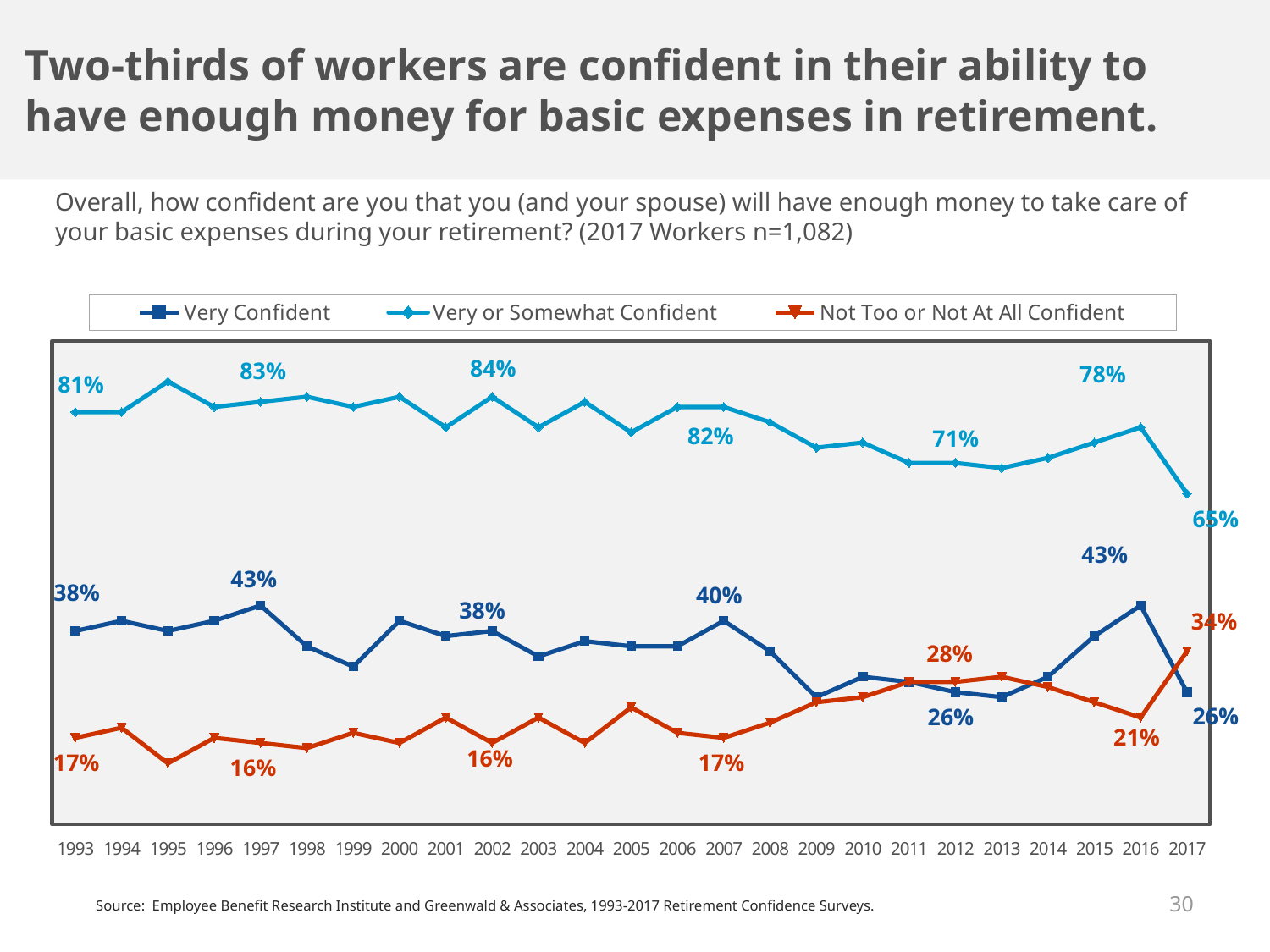
By how many percentage points did the Very Confident value change between 2012 and 2016? 17 percentage points What is the Very Confident value for 2007? 40% Which year has the larger Not Too or Not At All Confident value, 2012 or 2016? 2012 Does the Very or Somewhat Confident line rise or fall from 2016 to 2017? Fall What is the Very or Somewhat Confident value for 2002? 84% What is the Not Too or Not At All Confident value for 2012? 28% How many series does the legend list? 3 What kind of chart is shown on the slide? Line chart How many years are shown along the x axis? 25 What is the Very Confident value for 1997? 43% Which series is drawn with the red line? Not Too or Not At All Confident What is the Very or Somewhat Confident value for 1993? 81%